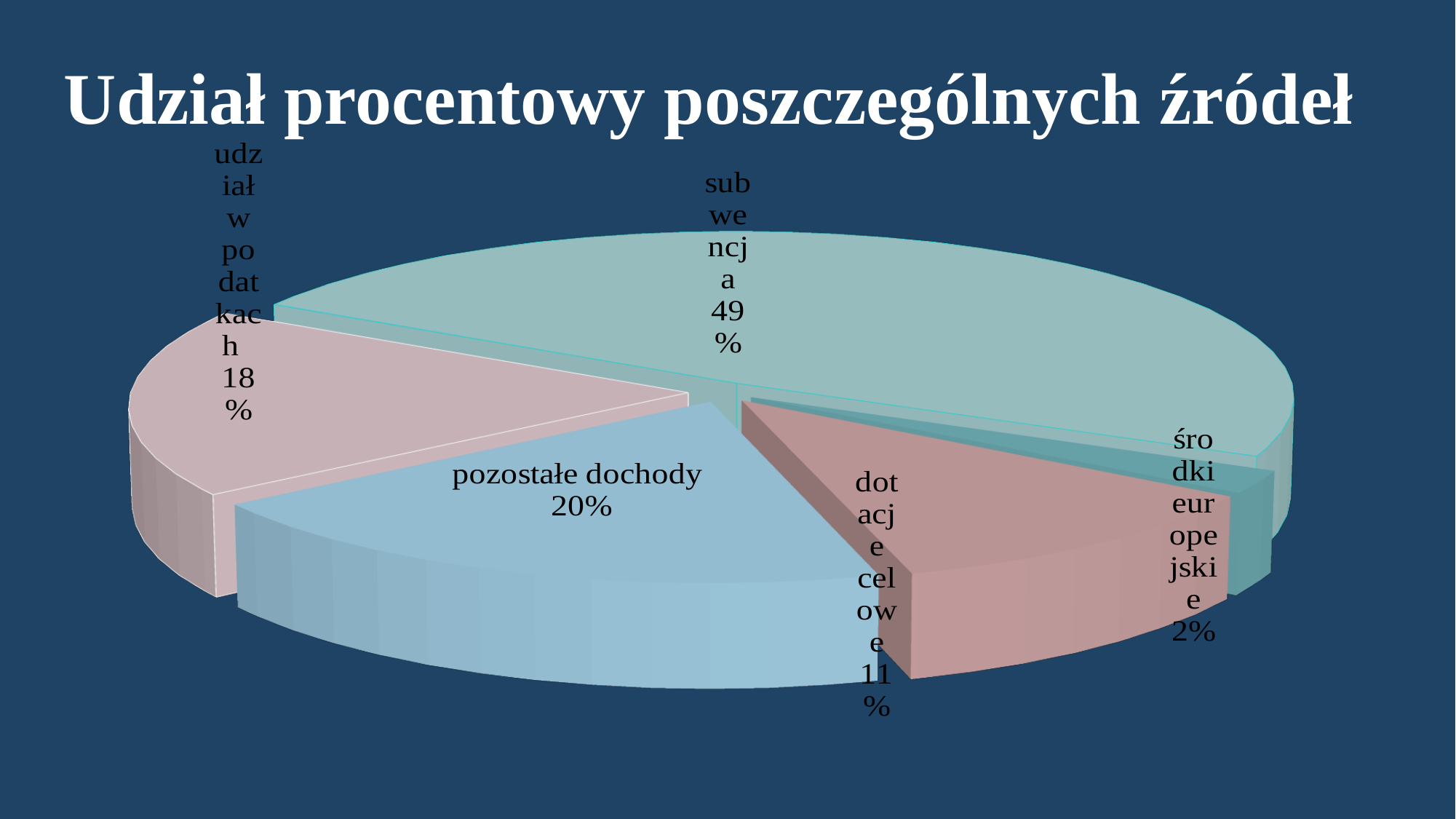
What is the title of the chart? Udział procentowy poszczególnych źródeł What is the share for udział w podatkach? 18% What is the share for środki europejskie? 2% Which category has the smallest share of the pie? środki europejskie What is the share for dotacje celowe? 11% What is the share for pozostałe dochody? 20% How many slices does the pie chart have? 5 What kind of chart is shown on the slide? pie chart Which is larger, the share for pozostałe dochody or the share for udział w podatkach? pozostałe dochody What is the share for subwencja? 49% Which category has the largest share of the pie? subwencja What is the difference between the shares of subwencja and pozostałe dochody? 29%